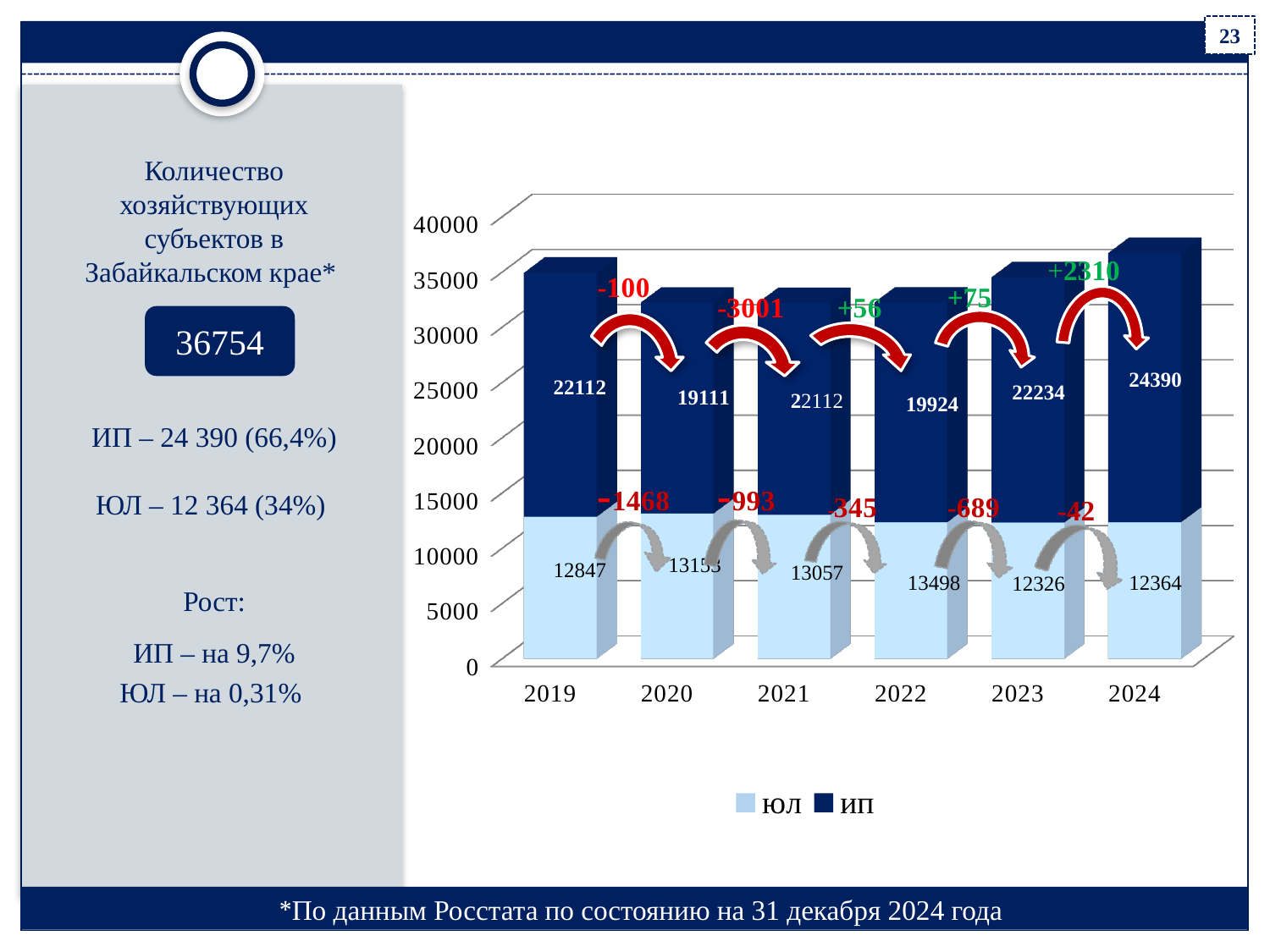
Which is larger, the ИП value in 2019 or in 2020? 2019 In which year is the ИП value lowest? 2020 What is the value for ЮЛ in 2019? 12847 What are the two entries in the chart legend? ЮЛ and ИП What is the value for ИП in 2024? 24390 What kind of chart is shown on the slide? bar chart What is the value for ЮЛ in 2022? 13498 What is the value for ИП in 2023? 22234 What is the total of the stacked bar for 2024 (ЮЛ plus ИП)? 36754 How many years are shown on the x axis of the chart? 6 In which year is the ИП value highest? 2024 How many series does the legend list? 2